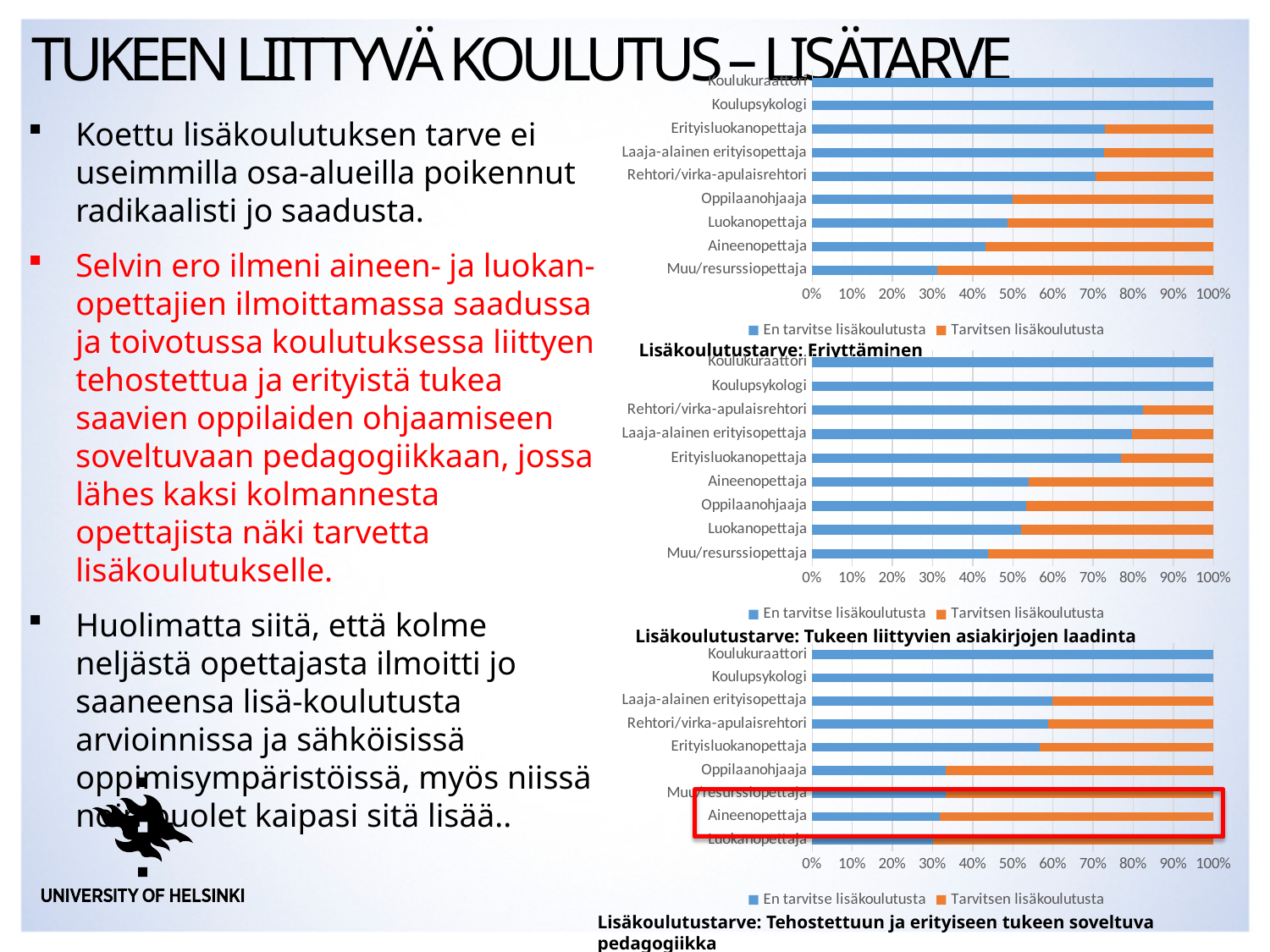
In the middle chart, is the 'En tarvitse lisäkoulutusta' value for Rehtori/virka-apulaisrehtori greater or less than 70%? greater In the top chart, which category has the smallest 'En tarvitse lisäkoulutusta' share? Muu/resurssiopettaja In the bottom chart, which has the larger 'En tarvitse lisäkoulutusta' share: Laaja-alainen erityisopettaja or Oppilaanohjaaja? Laaja-alainen erityisopettaja In the middle chart, is the 'En tarvitse lisäkoulutusta' value for Muu/resurssiopettaja greater or less than 50%? less What type of chart is the top chart on the slide? bar chart How many charts are shown on the slide? 3 In the top chart, is the 'En tarvitse lisäkoulutusta' value for Erityisluokanopettaja greater or less than 60%? greater In the charts on the slide, which colour represents 'Tarvitsen lisäkoulutusta'? orange How many categories are plotted in the top chart? 9 How many series does the legend of the top chart list? 2